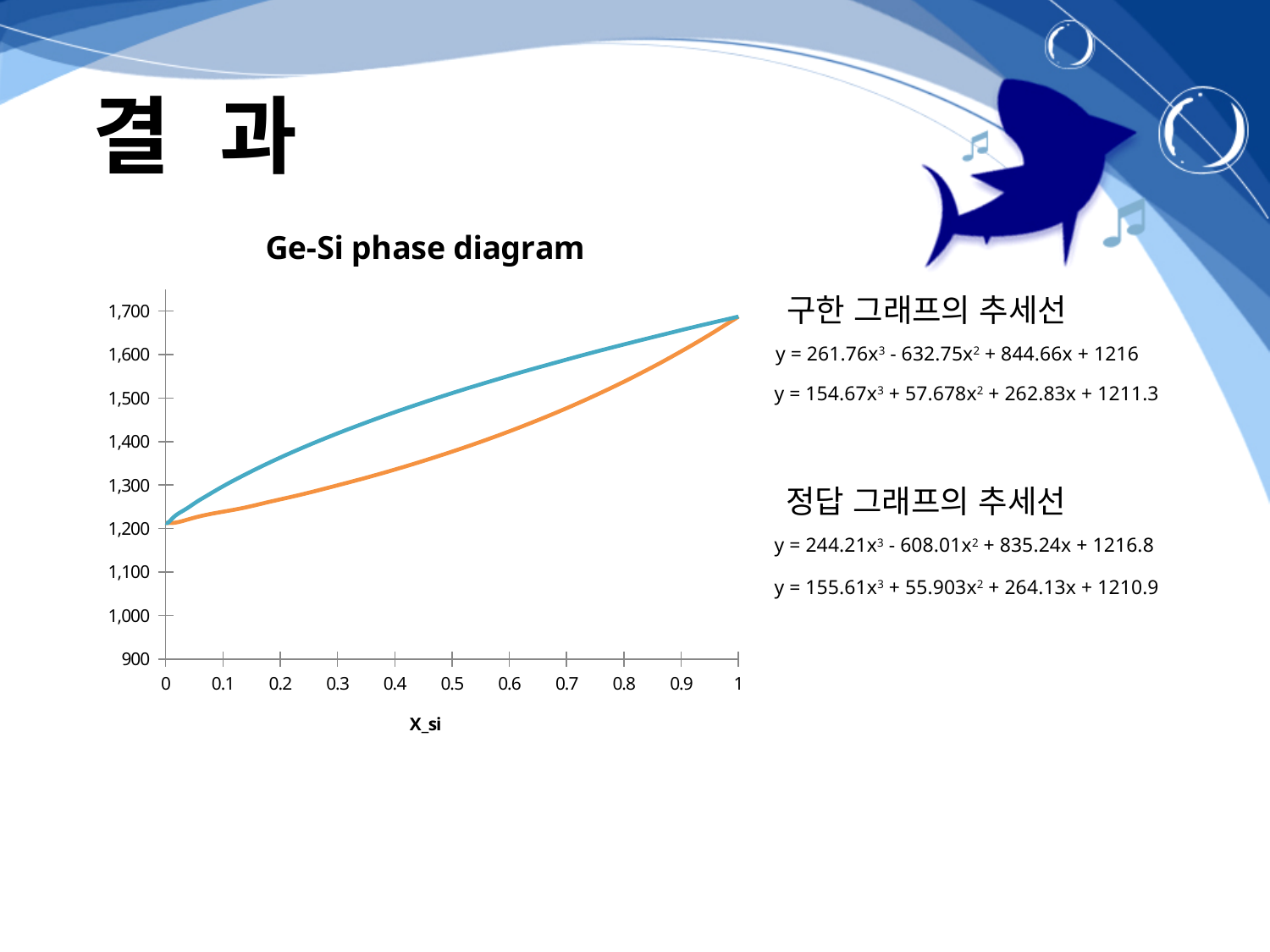
Is the value of the blue line at X_si = 0.2 greater or less than 1,300? greater Is the value of the orange line at X_si = 0.5 greater or less than 1,400? less Is the value of the orange line at X_si = 0.8 greater or less than 1,400? greater Do the values of the orange line rise or fall as X_si increases from 0 to 1? rise Do the values of the blue line rise or fall as X_si increases from 0 to 1? rise At X_si = 0.5, which line has the higher value, the blue line or the orange line? blue line What kind of chart is shown on the slide? line chart How many lines are plotted on the chart? 2 What is the title of the chart? Ge-Si phase diagram What is the label of the x axis of the chart? X_si